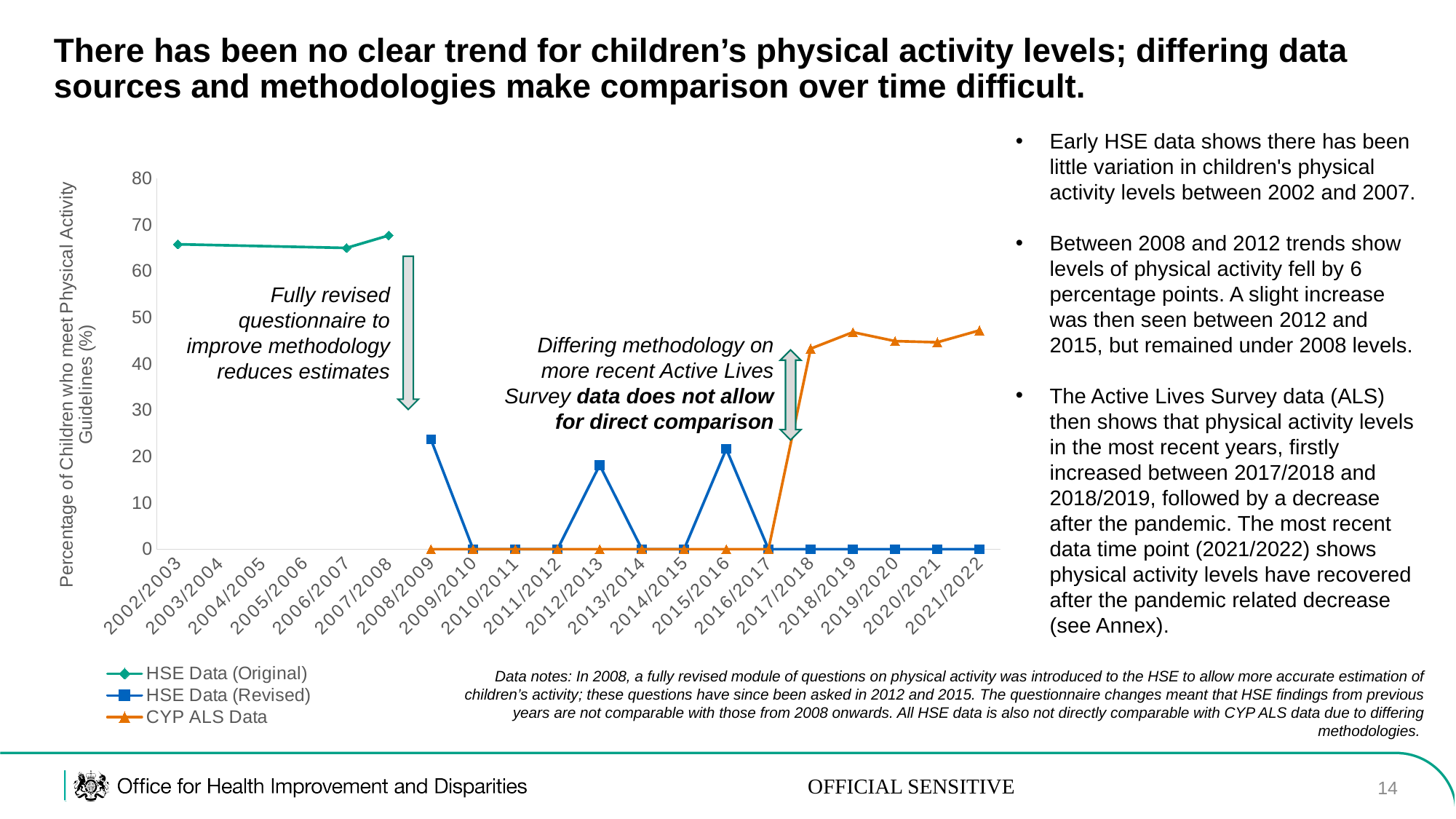
Is the CYP ALS Data value for 2018/2019 greater or less than 50? less Which year has the lowest non-zero CYP ALS Data value? 2017/2018 How many year categories are shown along the x axis of the chart? 20 Which is larger: the HSE Data (Revised) value for 2008/2009 or for 2012/2013? 2008/2009 What kind of chart is shown on the slide? Line chart Is the HSE Data (Revised) value for 2012/2013 greater or less than 20? less Is the HSE Data (Original) value for 2002/2003 greater or less than 60? greater How many series does the chart legend list? 3 Which is larger: the HSE Data (Original) value for 2007/2008 or the CYP ALS Data value for 2018/2019? HSE Data (Original) for 2007/2008 What is the label on the vertical axis of the chart? Percentage of Children who meet Physical Activity Guidelines (%) Which year has the lowest non-zero HSE Data (Revised) value? 2012/2013